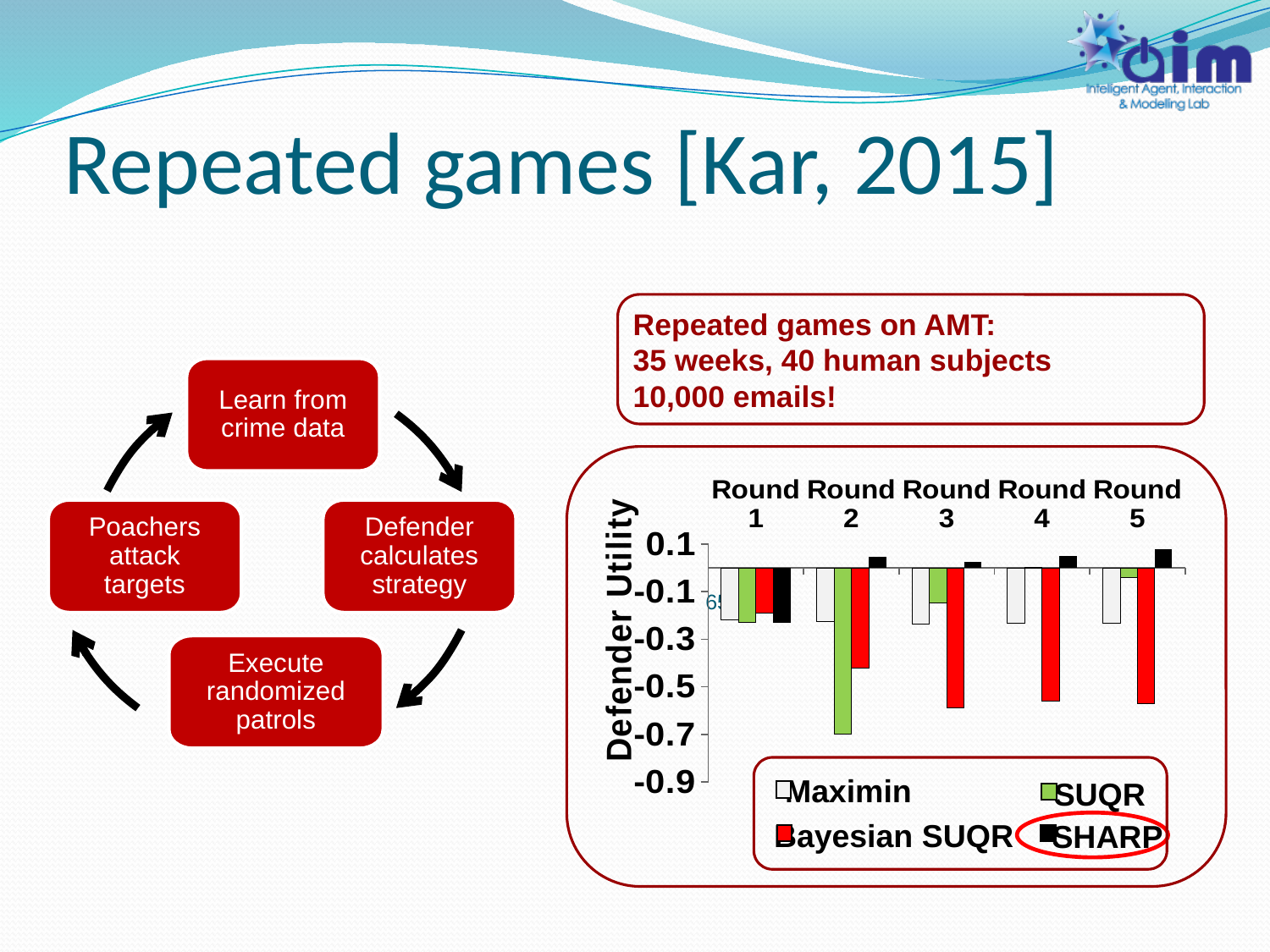
Is the Bayesian SUQR value in Round 1 greater or less than -0.3? greater Is the Bayesian SUQR value in Round 3 greater or less than -0.5? less Which legend entry is circled in red on the chart? SHARP Which series has the lowest Defender Utility in Round 2? SUQR What kind of chart is shown on the slide? bar chart What is the label of the chart's y axis? Defender Utility In Round 2, which is larger: the SHARP value or the Bayesian SUQR value? SHARP Which series has the highest Defender Utility in Round 5? SHARP Which series has the lowest Defender Utility in Round 4? Bayesian SUQR Is the SUQR value in Round 2 greater or less than -0.5? less How many series does the chart's legend list? 4 How many rounds are shown along the x axis of the chart? 5